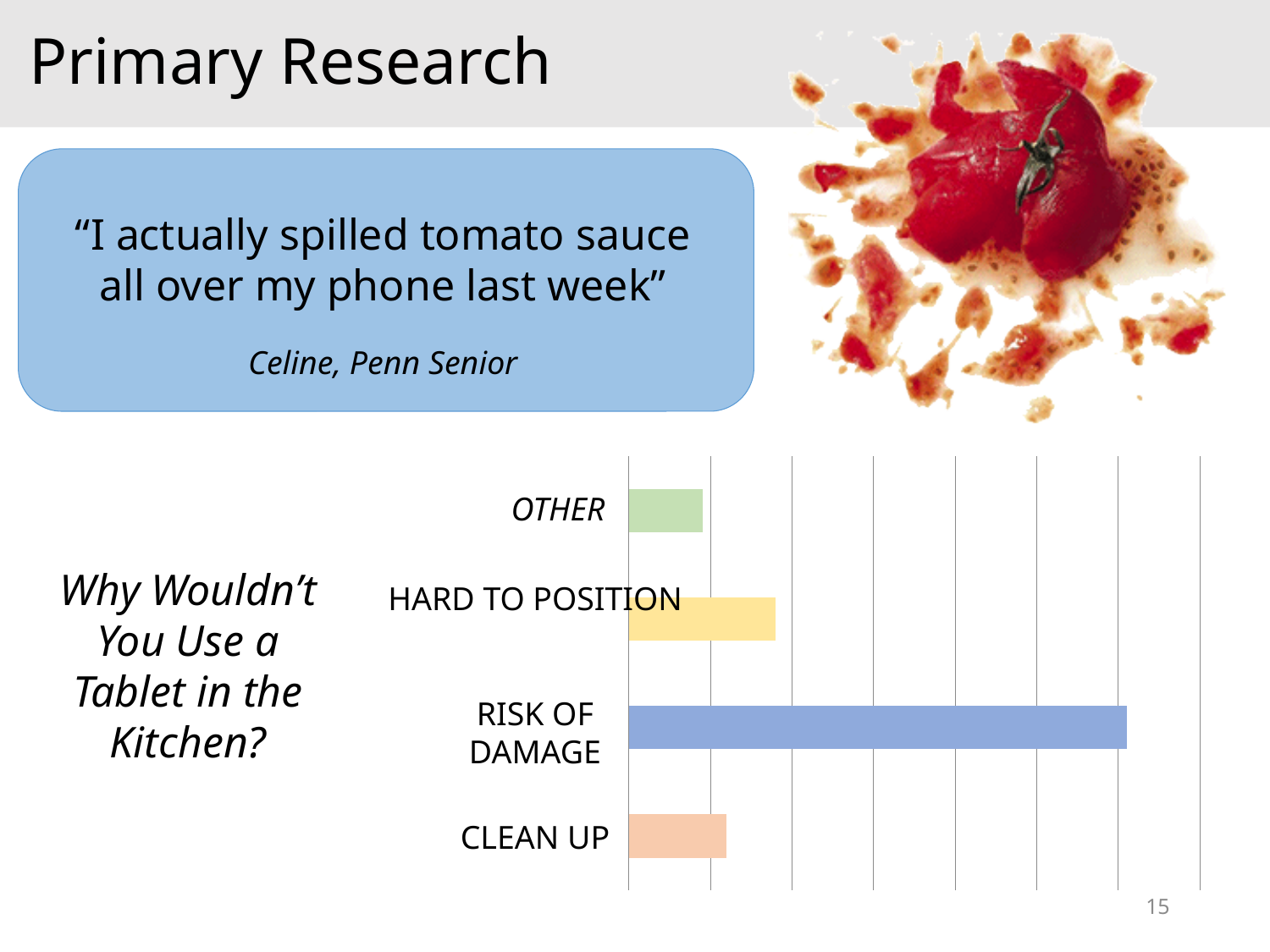
How many categories does the bar chart show? 4 Which bar is longer, HARD TO POSITION or CLEAN UP? HARD TO POSITION Which category has the longest bar in the chart? RISK OF DAMAGE Which bar is longer, HARD TO POSITION or OTHER? HARD TO POSITION What colour is the RISK OF DAMAGE bar? blue Which bar is shorter, RISK OF DAMAGE or CLEAN UP? CLEAN UP What kind of chart is shown on the slide? bar chart What question does the chart answer, according to the text to its left? Why Wouldn't You Use a Tablet in the Kitchen?